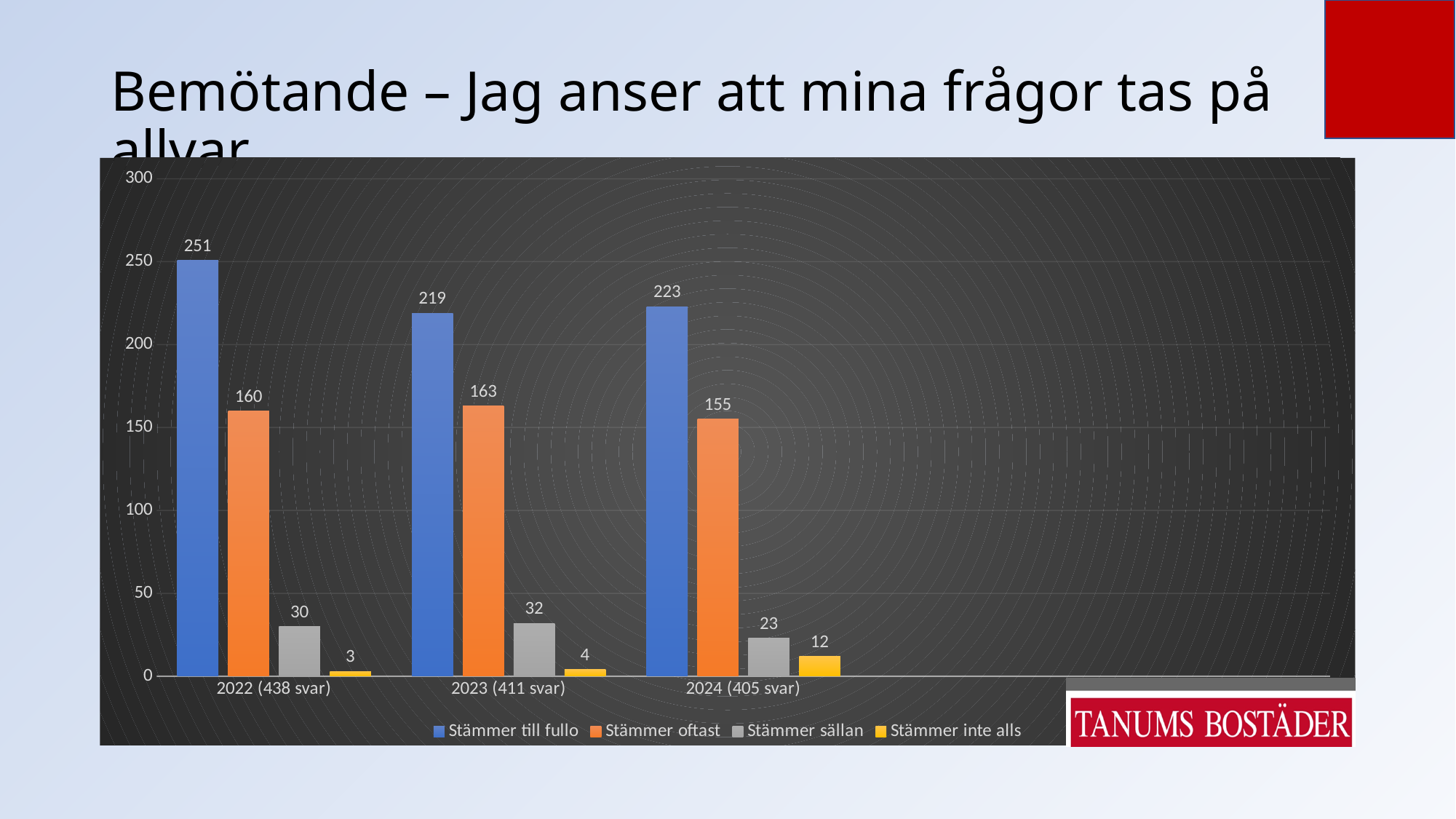
What is the value for 'Stämmer inte alls' in 2024 (405 svar)? 12 What is the value for 'Stämmer till fullo' in 2022 (438 svar)? 251 Which is larger: 'Stämmer oftast' in 2023 (411 svar) or 'Stämmer oftast' in 2024 (405 svar)? 2023 (411 svar) Which year has the highest value for 'Stämmer till fullo'? 2022 (438 svar) How many year categories are shown on the x axis? 3 How many series does the legend list? 4 What is the value for 'Stämmer sällan' in 2023 (411 svar)? 32 Is the value for 'Stämmer till fullo' in 2024 (405 svar) greater or less than 200? greater What is the difference between 'Stämmer till fullo' in 2022 (438 svar) and in 2023 (411 svar)? 32 What kind of chart is shown on the slide? Bar chart What is the value for 'Stämmer oftast' in 2024 (405 svar)? 155 Which year has the lowest value for 'Stämmer inte alls'? 2022 (438 svar)